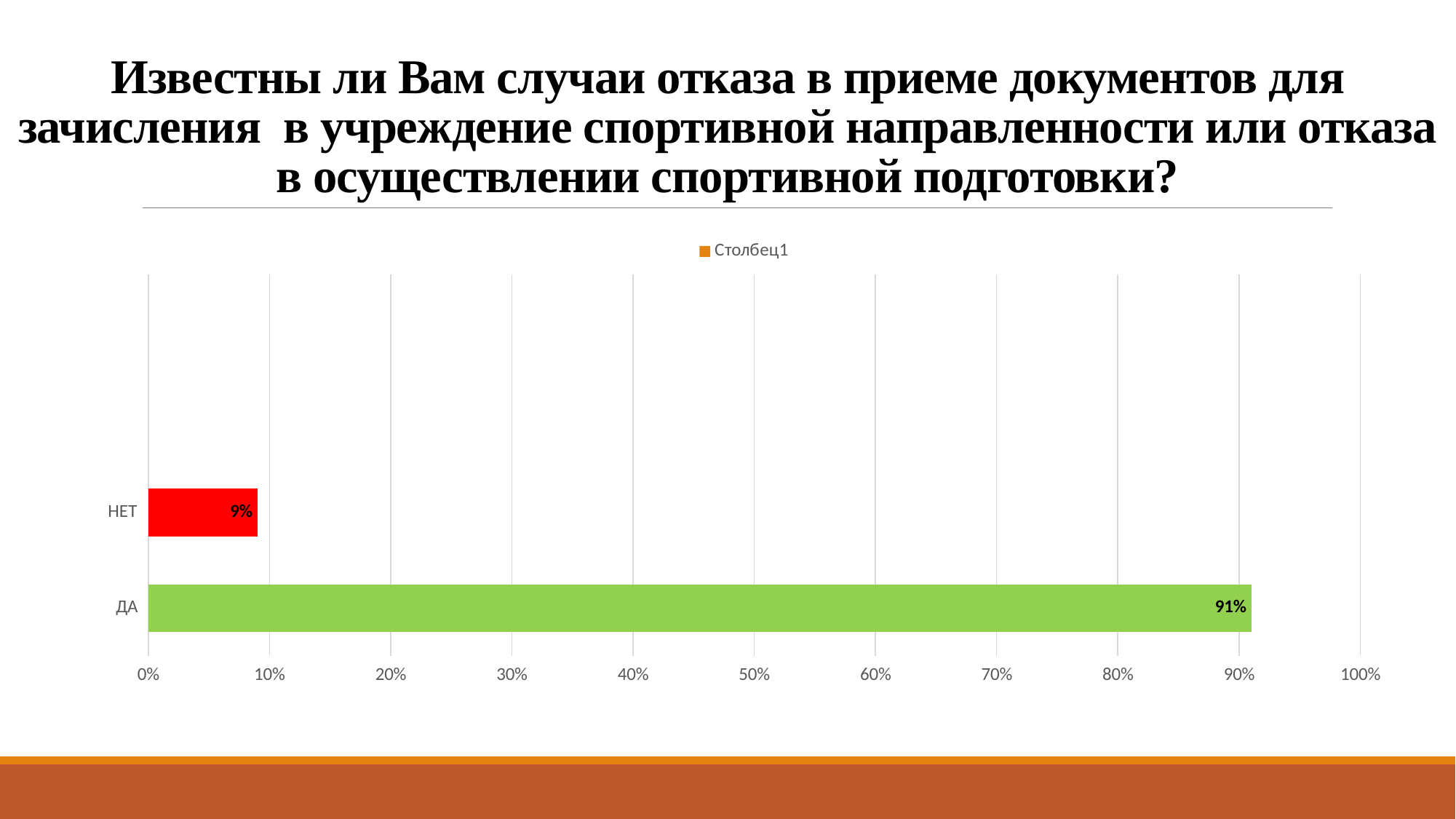
Which category has the lowest value? НЕТ What kind of chart is shown on the slide? bar chart Which is larger, the value for ДА or the value for НЕТ? ДА Is the value for НЕТ greater or less than 20%? less What is the name of the series shown in the legend? Столбец1 What is the value for ДА? 91% What is the difference between the values for ДА and НЕТ? 82% How many series does the legend list? 1 Is the value for ДА greater or less than 50%? greater How many categories are shown in the chart? 2 What is the value for НЕТ? 9% Which category has the highest value? ДА